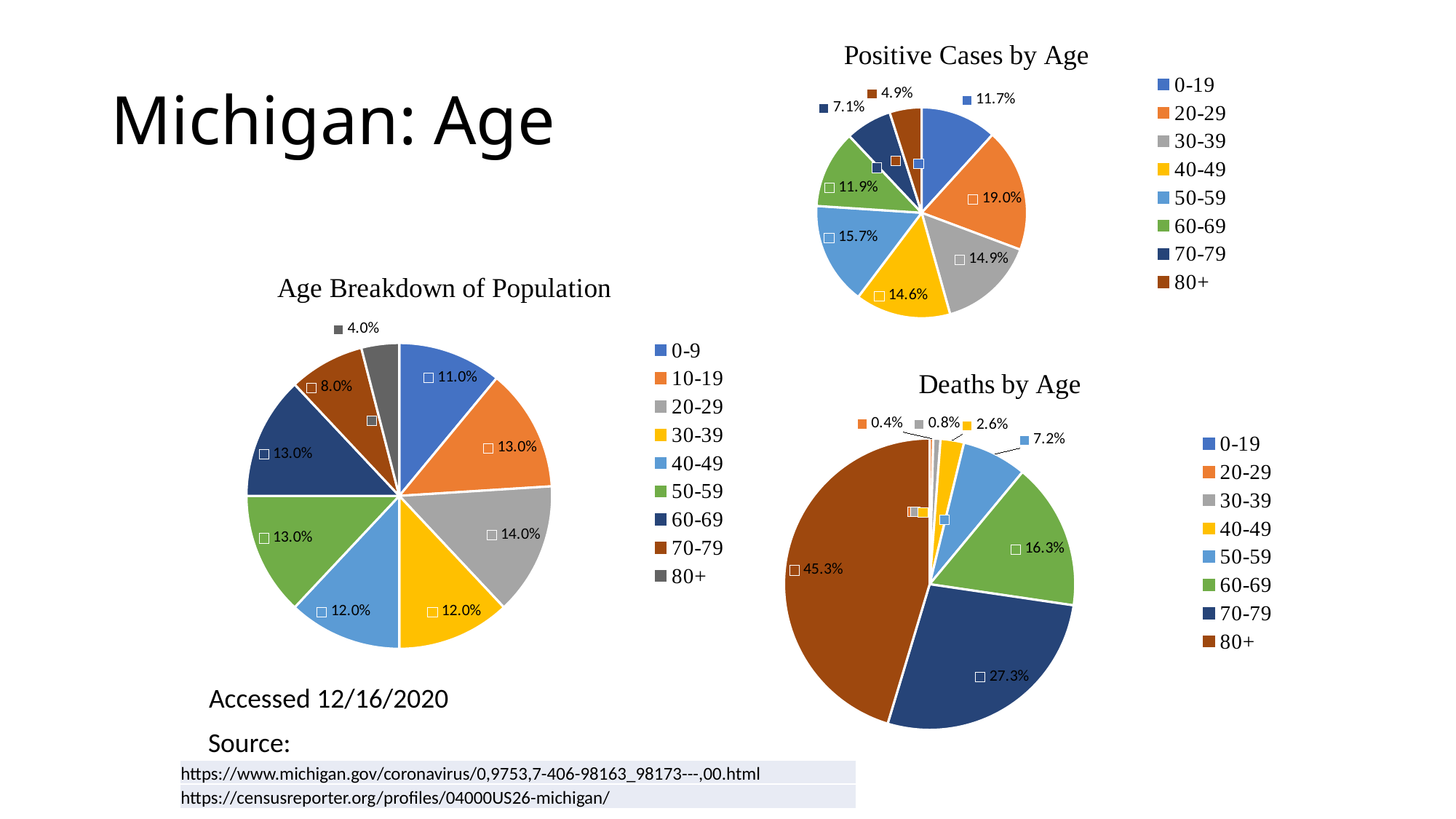
In the Age Breakdown of Population chart, which age group has the largest share? 20-29 In the Deaths by Age chart, which age group has the largest share of deaths? 80+ In the Age Breakdown of Population chart, how many age groups does the legend list? 9 In the Deaths by Age chart, what is the combined share of the 70-79 and 80+ age groups? 72.6% What type of chart is the Deaths by Age chart? Pie chart In the Positive Cases by Age chart, what percentage of positive cases are in the 20-29 age group? 19.0% In the Age Breakdown of Population chart, what share of the population is aged 80+? 4.0% In the Deaths by Age chart, which is larger, the share for 60-69 or the share for 50-59? 60-69 In the Deaths by Age chart, what percentage of deaths are in the 80+ age group? 45.3% In the Age Breakdown of Population chart, what share of the population is aged 20-29? 14.0% In the Positive Cases by Age chart, which age group has the smallest share of positive cases? 80+ In the Positive Cases by Age chart, what is the difference between the 50-59 share and the 70-79 share? 8.6%